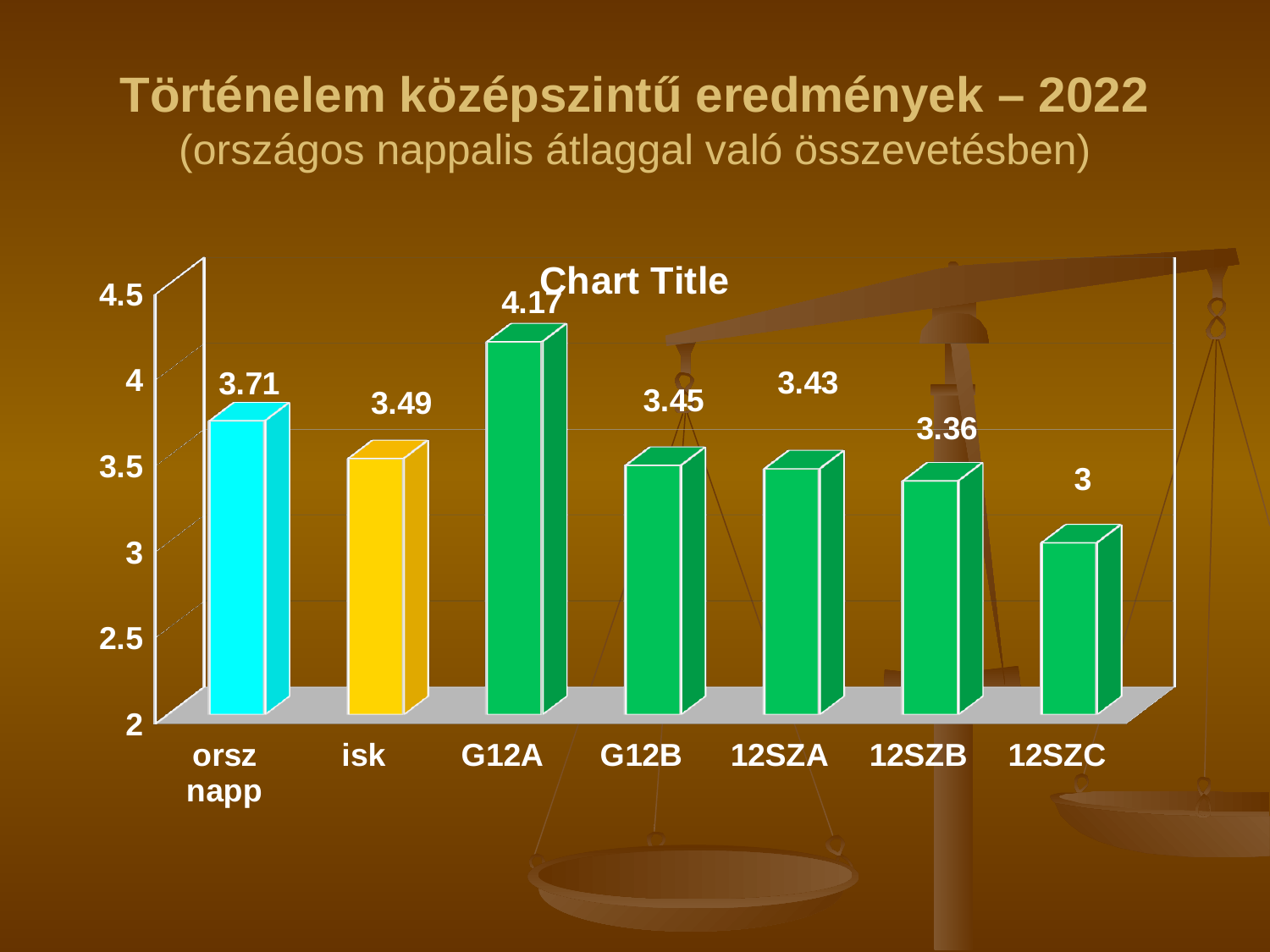
Which is larger, the value for isk or the value for G12B? isk Which category has the lowest value? 12SZC What colour is the bar for isk? yellow Is the value for 12SZA greater or less than 3.5? less What is the value for G12A? 4.17 Which category has the highest value? G12A What is the difference between the values for orsz napp and isk? 0.22 What is the difference between the values for G12A and 12SZC? 1.17 What is the value for orsz napp? 3.71 What kind of chart is shown on the slide? bar chart How many categories are shown on the x axis? 7 What is the value for 12SZB? 3.36